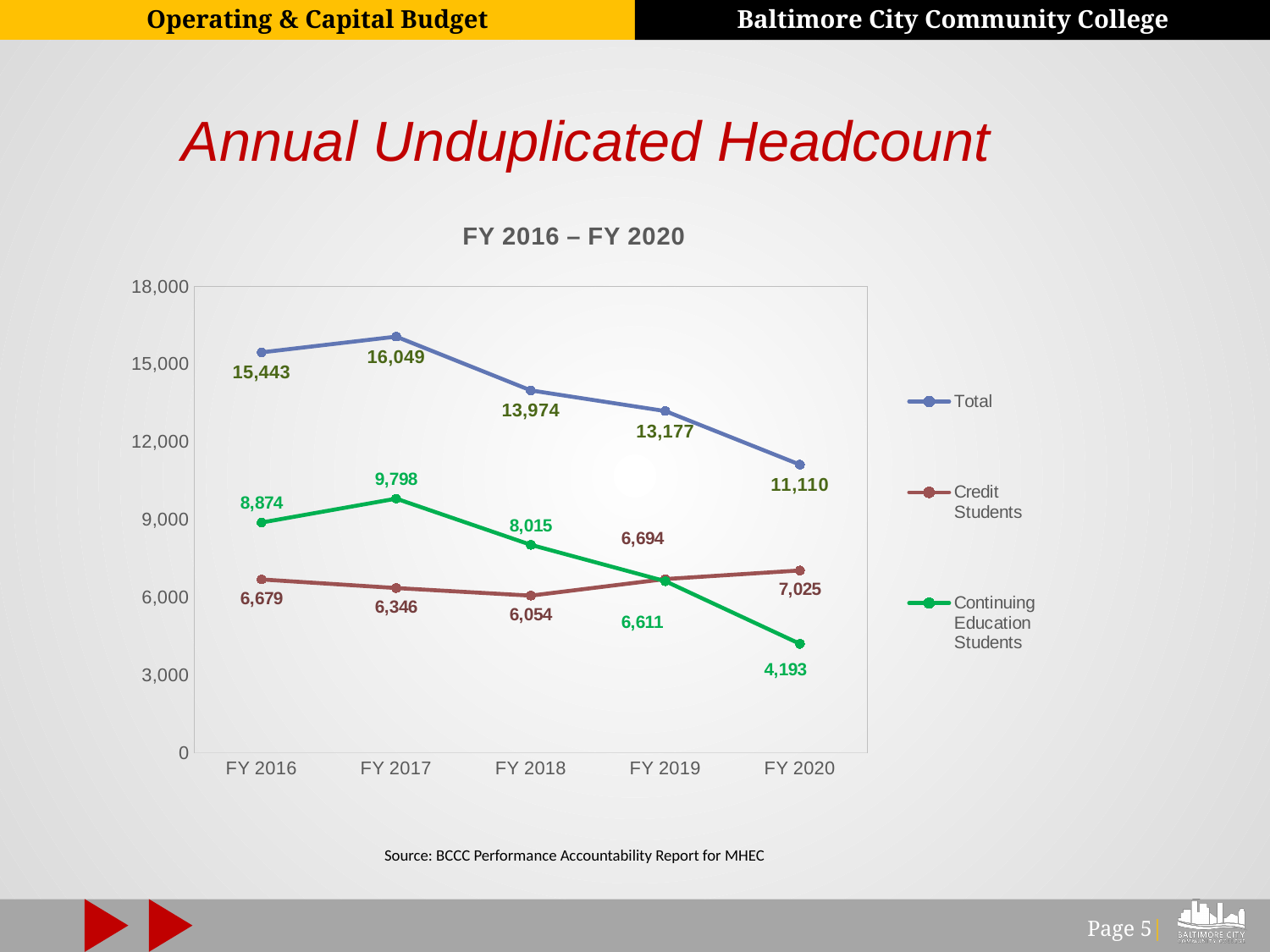
What is the Total headcount for FY 2017? 16,049 How many fiscal years are plotted on the x axis? 5 In which fiscal year is the Total headcount highest? FY 2017 What is the difference between the Total headcount in FY 2016 and FY 2020? 4,333 In which fiscal year is the Continuing Education Students headcount lowest? FY 2020 What is the Credit Students headcount for FY 2018? 6,054 What is the subtitle shown above the chart? FY 2016 – FY 2020 What is the Continuing Education Students headcount for FY 2020? 4,193 How many series does the legend list? 3 Does the Continuing Education Students headcount rise or fall from FY 2017 to FY 2020? Fall Which is larger in FY 2019, the Credit Students headcount or the Continuing Education Students headcount? Credit Students What type of chart is shown on the slide? Line chart